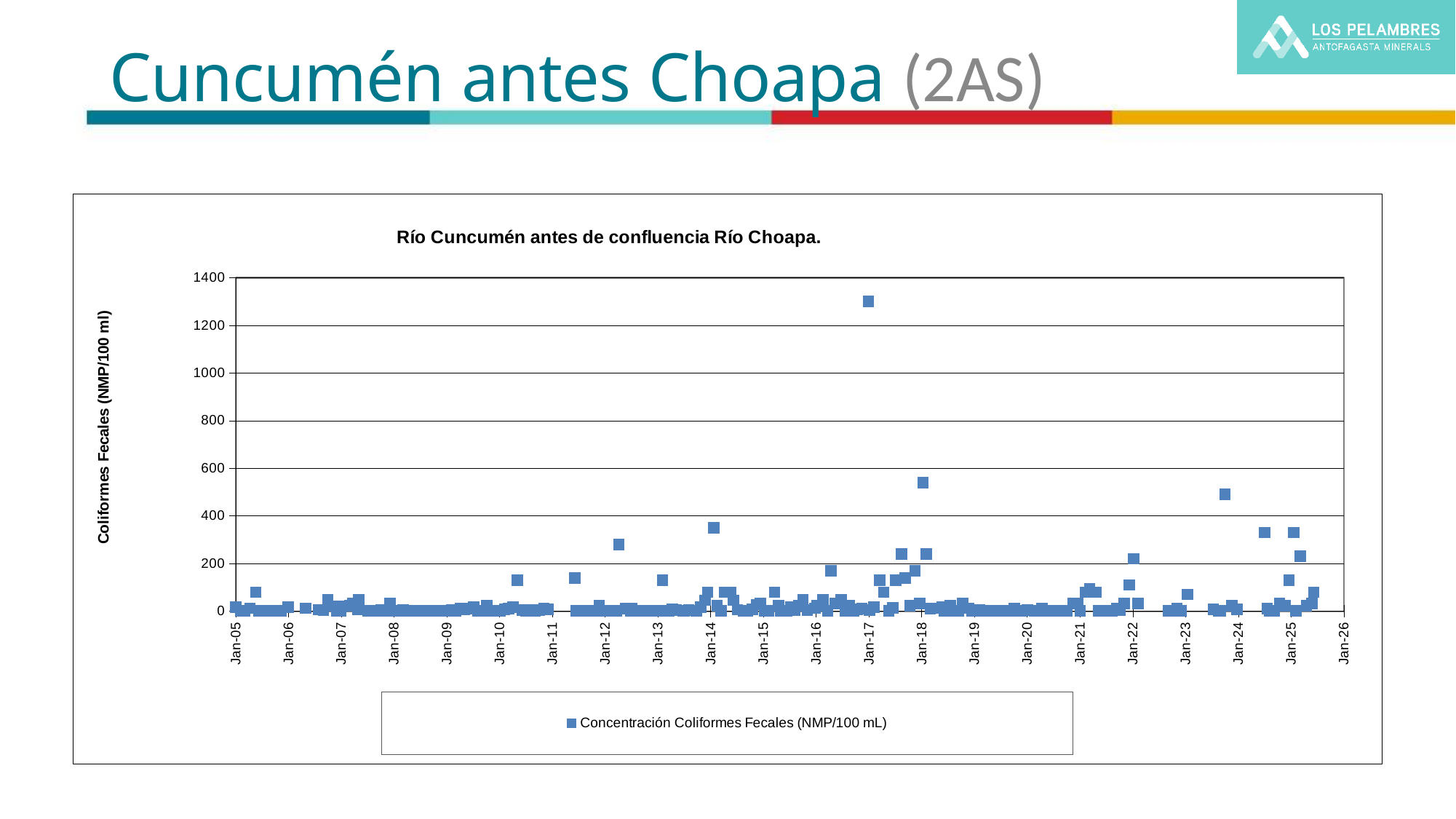
What kind of chart is shown on the slide? scatter chart What is the label of the series shown in the legend? Concentración Coliformes Fecales (NMP/100 mL) Around which x-axis date does the highest plotted value occur? Jan-17 Is the highest plotted value (near Jan-17) greater or less than 1200? greater Is the peak value plotted just before Jan-14 greater or less than 400? less How many series does the chart legend list? 1 Is the peak value plotted near Jan-18 greater or less than 400? greater Which is larger: the peak value near Jan-17 or the peak value near Jan-18? the peak near Jan-17 What is the title of the chart? Río Cuncumén antes de confluencia Río Choapa. What is the highest tick value shown on the y axis? 1400